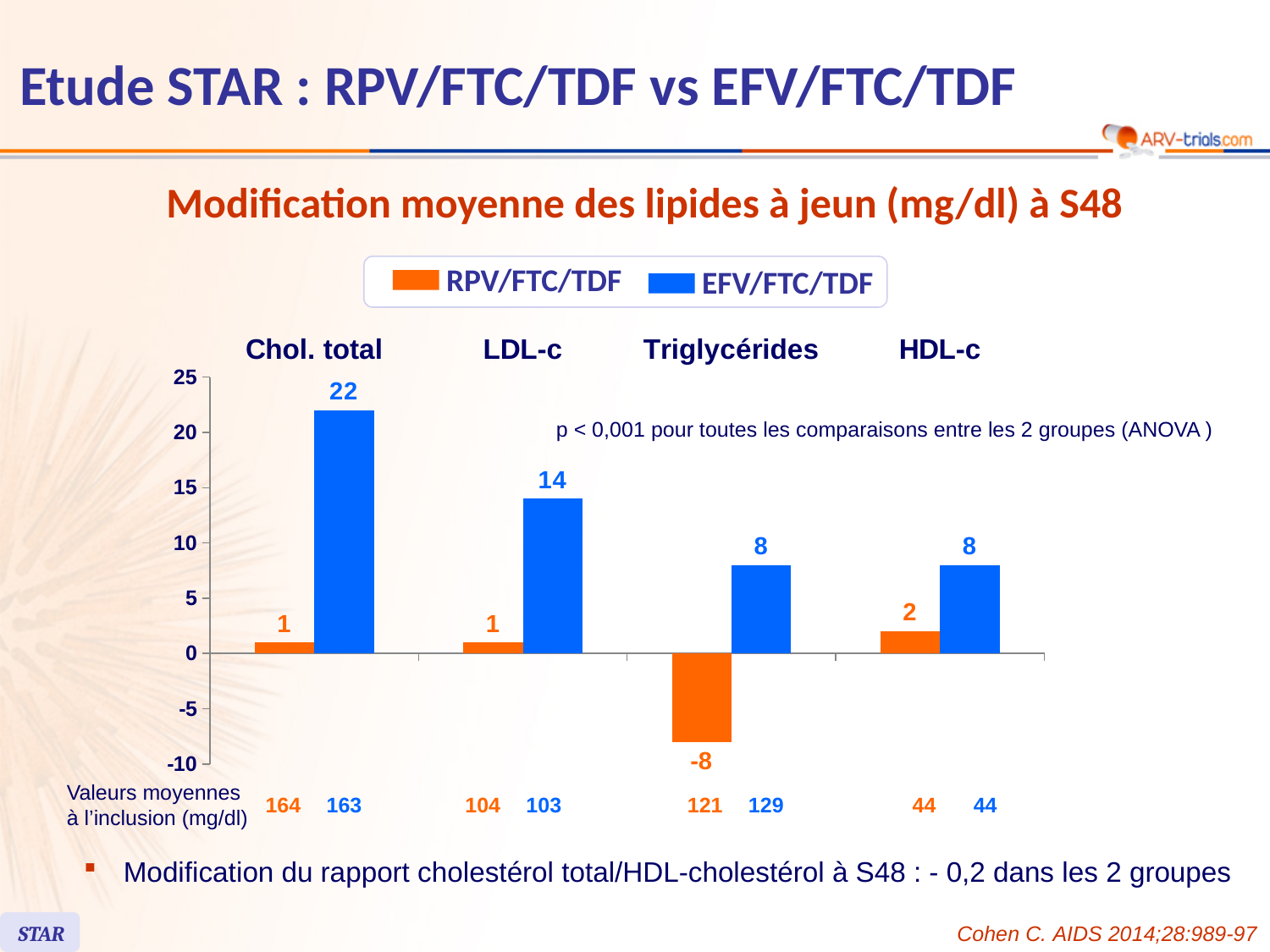
What is the mean change in total cholesterol (Chol. total) for the EFV/FTC/TDF group? 22 What is the mean change in triglycerides for the RPV/FTC/TDF group? -8 What kind of chart is shown on the slide? Bar chart What is the mean change in LDL-c for the EFV/FTC/TDF group? 14 Which lipid category shows the lowest value for the RPV/FTC/TDF group? Triglycérides How many lipid categories are shown on the chart? 4 How many series does the legend list? 2 What is the difference between the EFV/FTC/TDF and RPV/FTC/TDF values for Chol. total? 21 Which lipid category shows the highest value for the EFV/FTC/TDF group? Chol. total Which colour represents the RPV/FTC/TDF group in the chart? Orange For LDL-c, which group has the larger mean change, RPV/FTC/TDF or EFV/FTC/TDF? EFV/FTC/TDF What is the mean change in HDL-c for the RPV/FTC/TDF group? 2